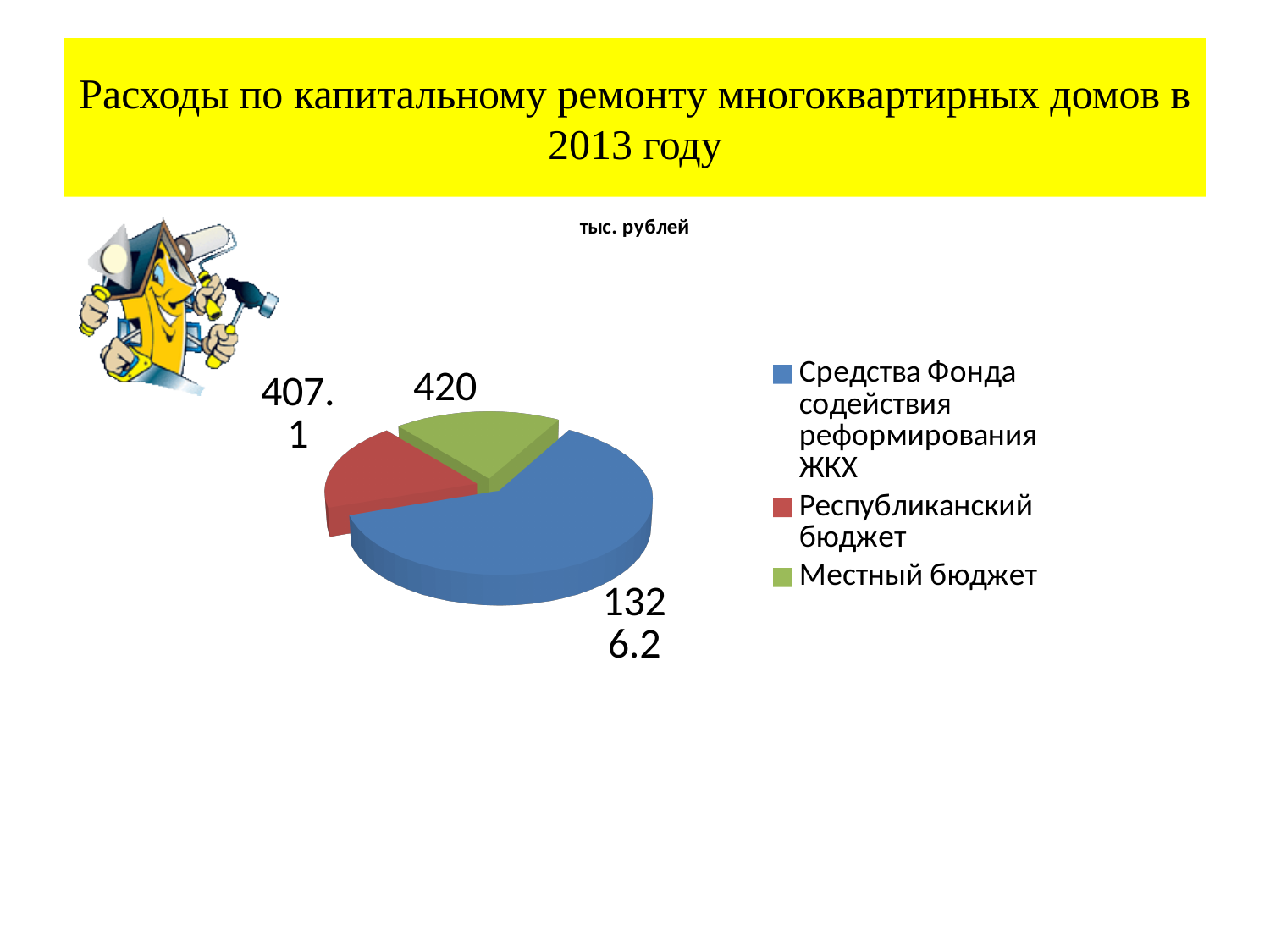
Which category has the smallest slice of the pie? Республиканский бюджет What is the difference between the values for Средства Фонда содействия реформирования ЖКХ and Республиканский бюджет? 919.1 What is the value for Местный бюджет? 420 What unit is given in the chart title above the pie? тыс. рублей How many entries does the legend list? 3 How many slices does the pie chart have? 3 What kind of chart is shown on the slide? Pie chart What is the difference between the values for Местный бюджет and Республиканский бюджет? 12.9 What is the value for Республиканский бюджет? 407.1 What is the value for Средства Фонда содействия реформирования ЖКХ? 1326.2 Which category has the largest slice of the pie? Средства Фонда содействия реформирования ЖКХ Which is larger, the value for Местный бюджет or the value for Республиканский бюджет? Местный бюджет